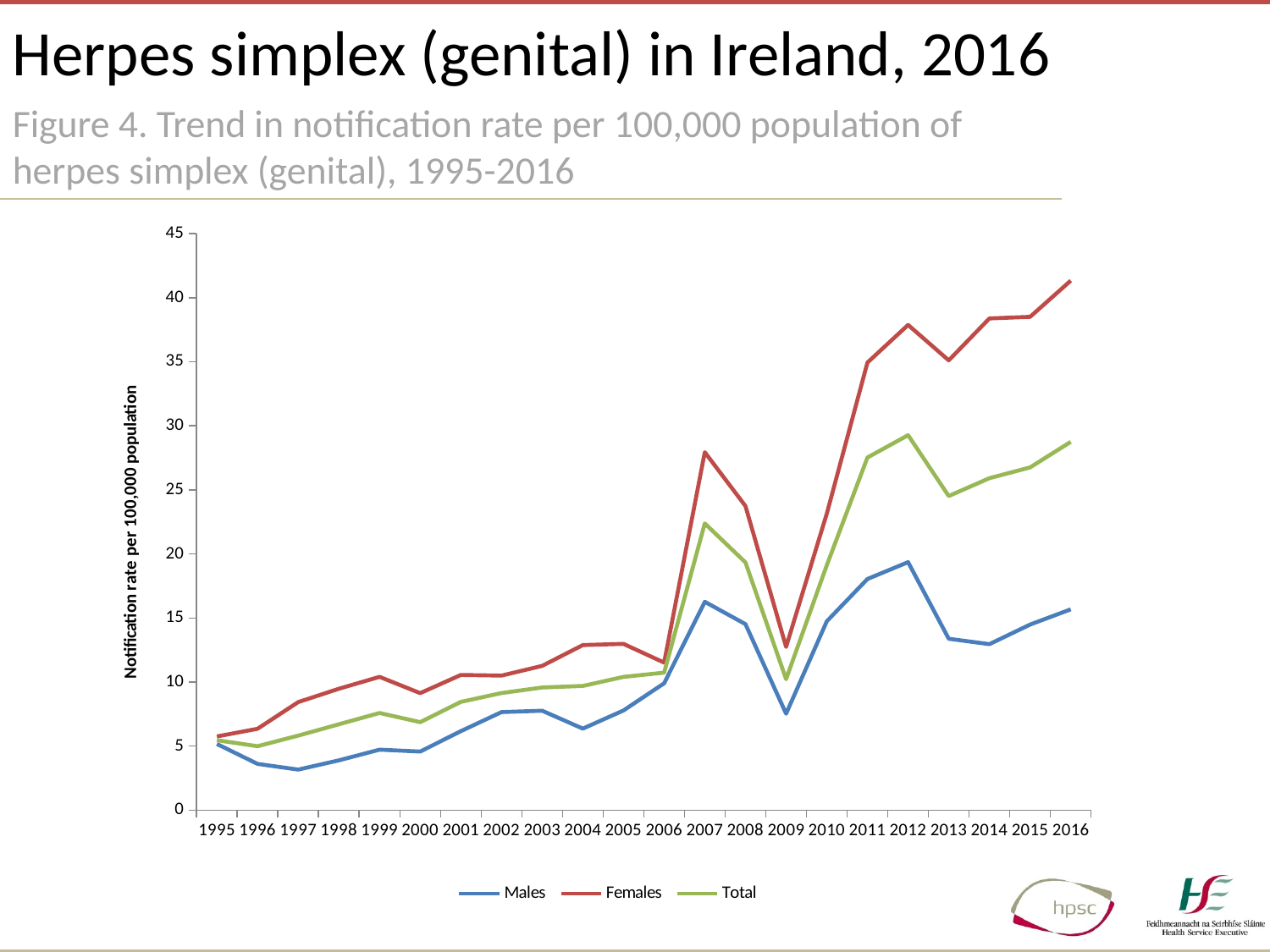
Is the Males value for 2012 greater or less than 15? greater Which series has the highest value in 2016? Females Is the Males value for 2009 greater or less than 10? less Which is larger, the Total value in 2007 or the Total value in 2009? 2007 How many years are plotted along the x axis? 22 What kind of chart is shown on the slide? line chart Does the Females series rise or fall from 2013 to 2016? rise Is the Females value for 2016 greater or less than 40? greater How many series does the legend list? 3 In which year does the Females series reach its highest value? 2016 In which year does the Males series reach its highest value? 2012